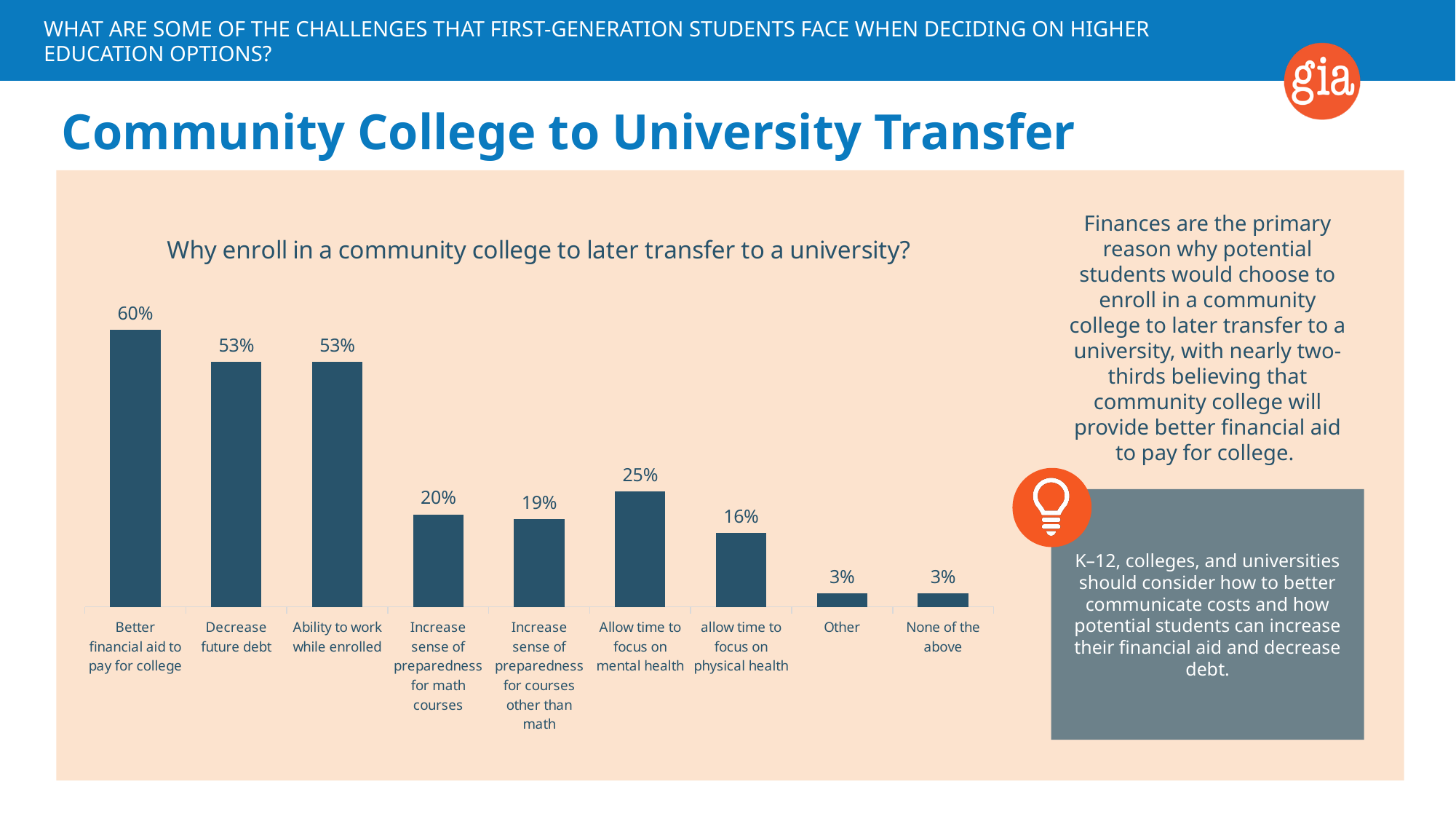
What type of chart is shown on the slide? Bar chart What is the title of the chart? Why enroll in a community college to later transfer to a university? Which is larger: the value for "Increase sense of preparedness for math courses" or the value for "Allow time to focus on mental health"? Allow time to focus on mental health What is the difference between the values for "Allow time to focus on mental health" and "allow time to focus on physical health"? 9% Which two categories share the same value of 53%? Decrease future debt and Ability to work while enrolled What is the lowest value shown in the chart? 3% What is the value shown for "Increase sense of preparedness for courses other than math"? 19% What is the value shown for "Allow time to focus on mental health"? 25% How many categories are shown in the chart? 9 What is the difference between the values for "Better financial aid to pay for college" and "Decrease future debt"? 7% Which category has the highest value in the chart? Better financial aid to pay for college What percentage of respondents chose "Better financial aid to pay for college" as a reason to enroll in a community college to later transfer to a university? 60%